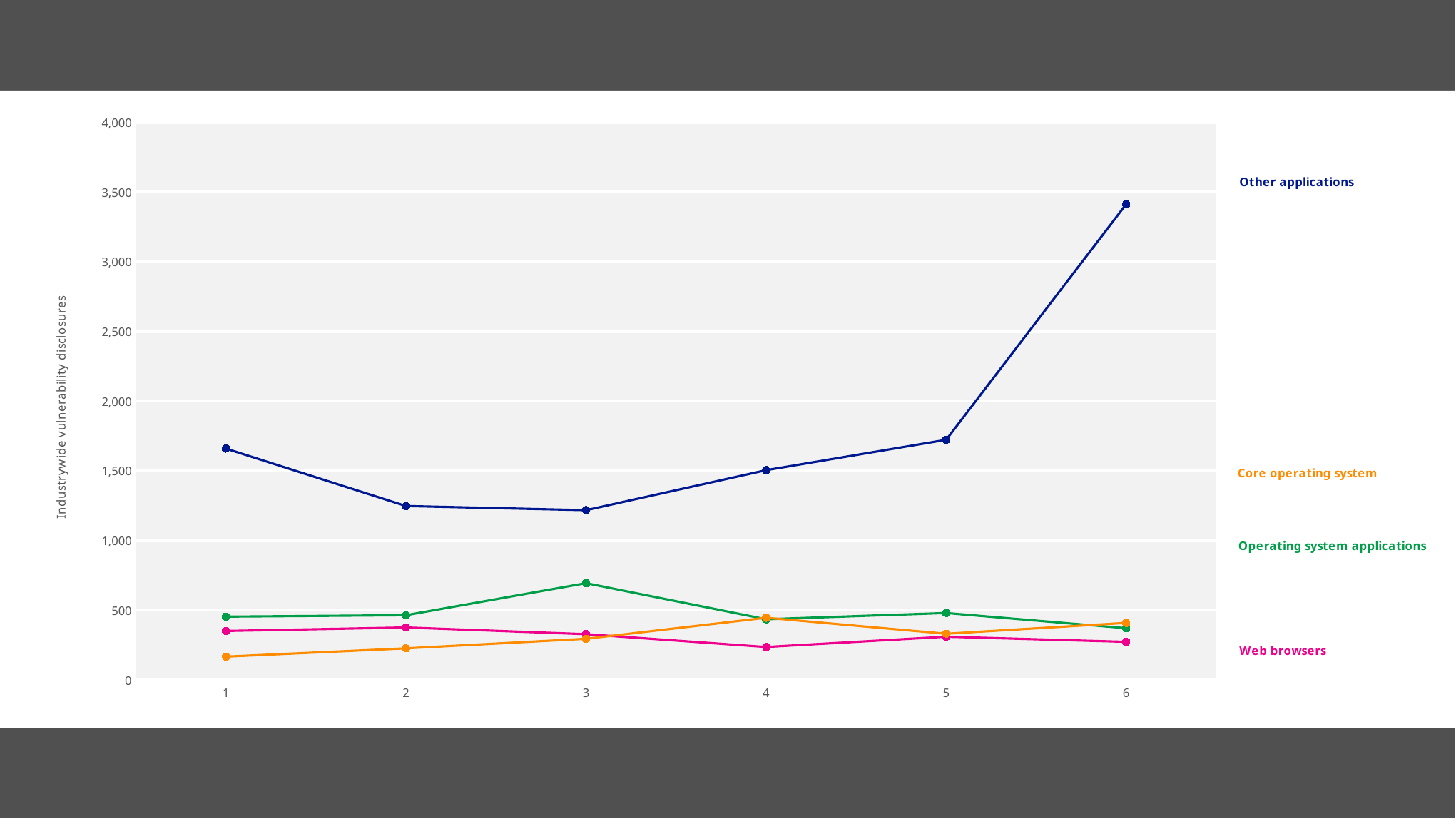
What is the label on the vertical axis of the chart? Industrywide vulnerability disclosures What kind of chart is shown on the slide? line chart At which x-axis point does the Other applications series reach its highest value? 6 Is the value for Other applications at point 2 greater or less than 1,500? less Is the value for Other applications at point 6 greater or less than 3,000? greater How many points are there along the x axis? 6 At which x-axis point does the Operating system applications series peak? 3 At which x-axis point is the Core operating system series at its lowest? 1 At point 3, which is larger: Operating system applications or Web browsers? Operating system applications How many series are plotted on the chart? 4 Is the value for Operating system applications at point 3 greater or less than 500? greater Does the Other applications series rise or fall from point 5 to point 6? rise